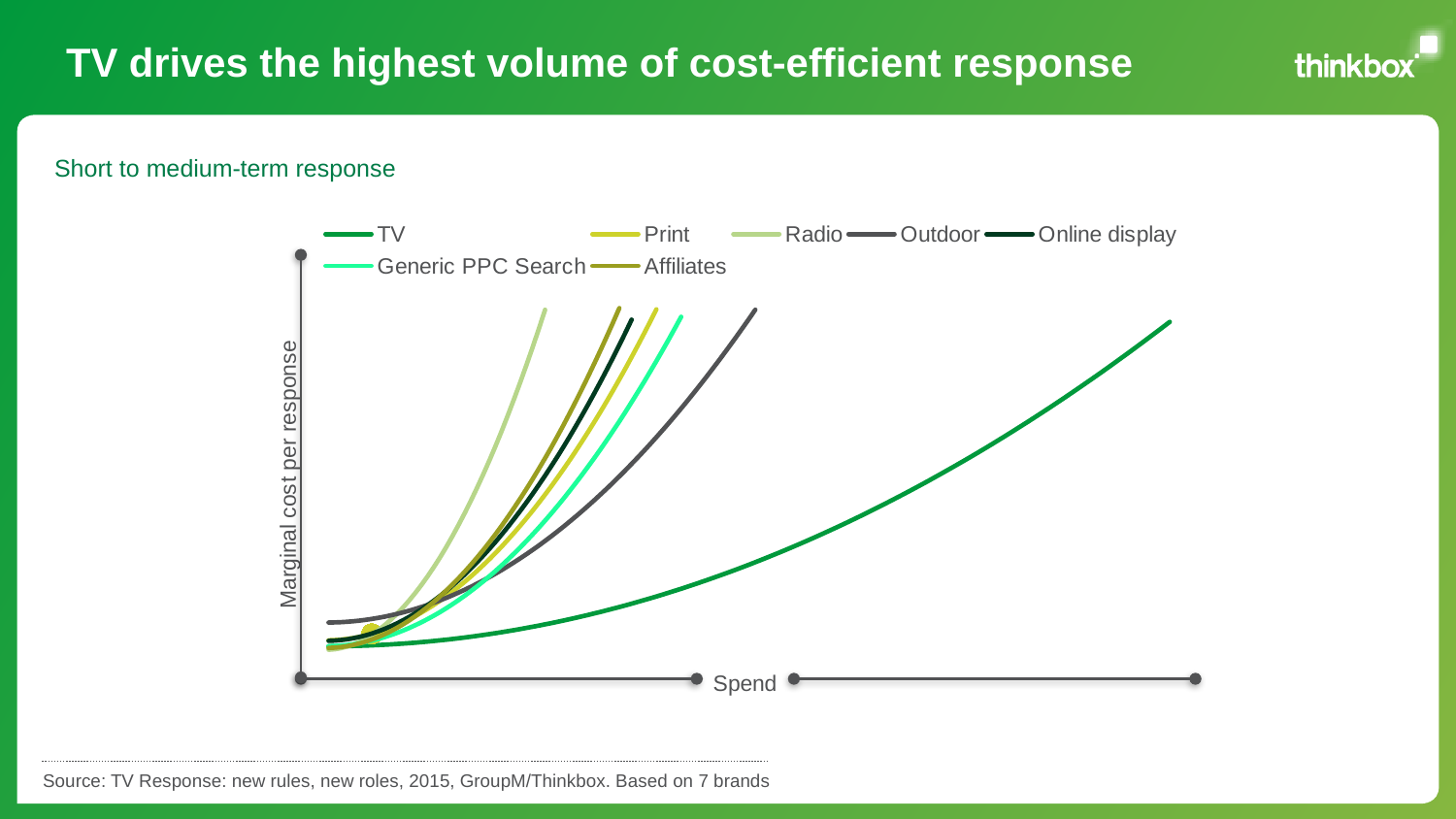
Which series reaches the top of the chart at the lowest spend? Radio What is the label of the y axis? Marginal cost per response Which series starts at the highest marginal cost per response at the lowest spend? Outdoor How many series does the legend list? 7 What kind of chart is shown on the slide? Line chart Which series rises more steeply with spend, Radio or TV? Radio At high spend, which series has the lower marginal cost per response, TV or Outdoor? TV Do the curves rise or fall as spend increases along the x axis? Rise What is the label of the x axis? Spend Which series extends furthest along the Spend axis before reaching the top of the chart? TV